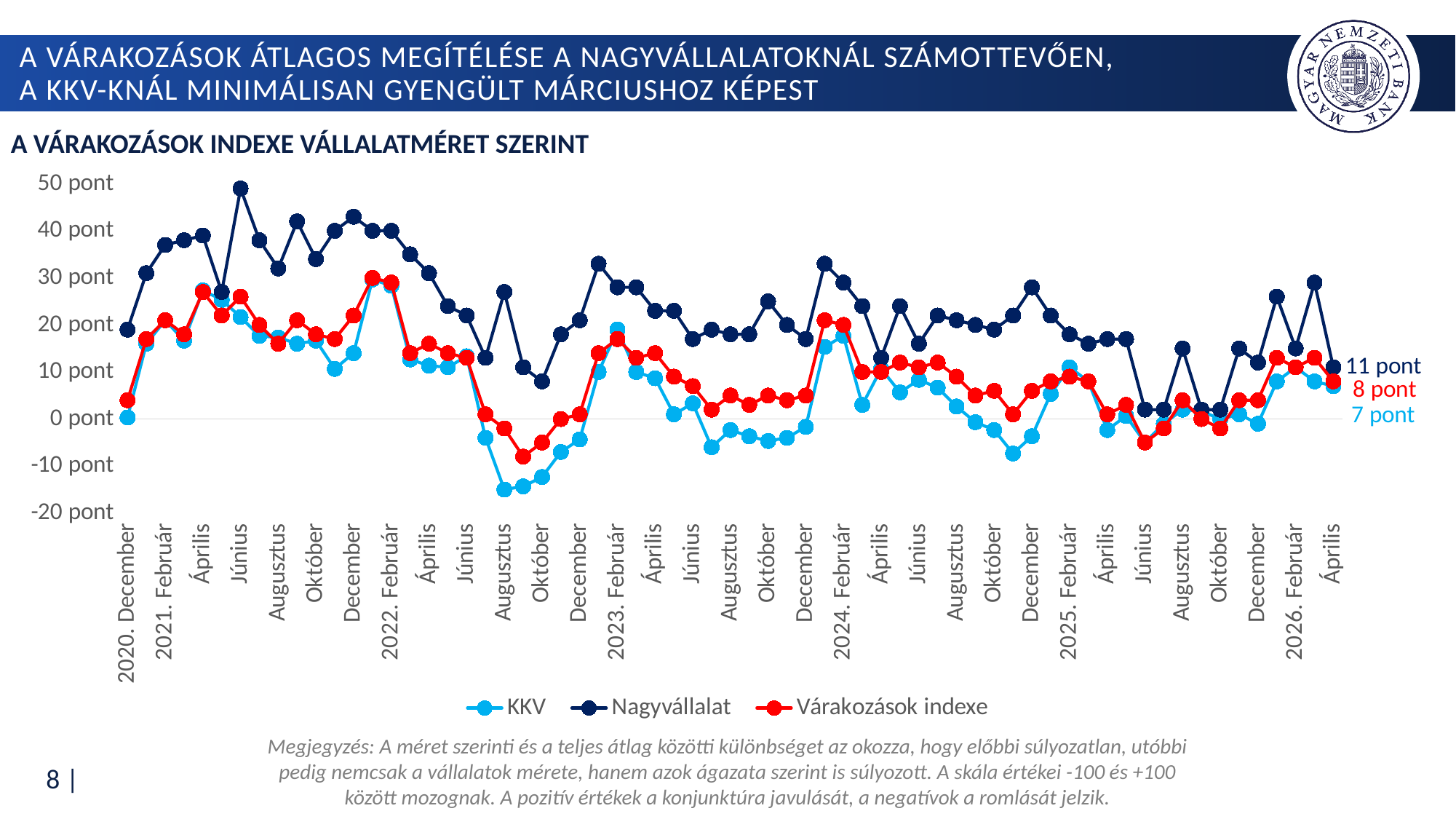
What is the value of the KKV series at the last point (2026. Április)? 7 pont Does the Nagyvállalat series rise or fall between 2020. December and 2021. Június? rise Is the KKV value in 2022. Augusztus greater or less than -10 pont? less At the last point (2026. Április), what is the difference between the Nagyvállalat value and the KKV value? 4 pont Which series reaches the highest value anywhere on the chart? Nagyvállalat How many series does the legend list? 3 What is the title of the chart? A VÁRAKOZÁSOK INDEXE VÁLLALATMÉRET SZERINT At the last point (2026. Április), which is higher: Nagyvállalat or KKV? Nagyvállalat What is the value of the Várakozások indexe series at the last point (2026. Április)? 8 pont What is the value of the Nagyvállalat series at the last point (2026. Április)? 11 pont Is the Nagyvállalat value in 2021. Június greater or less than 40 pont? greater What kind of chart is shown on the slide? Line chart